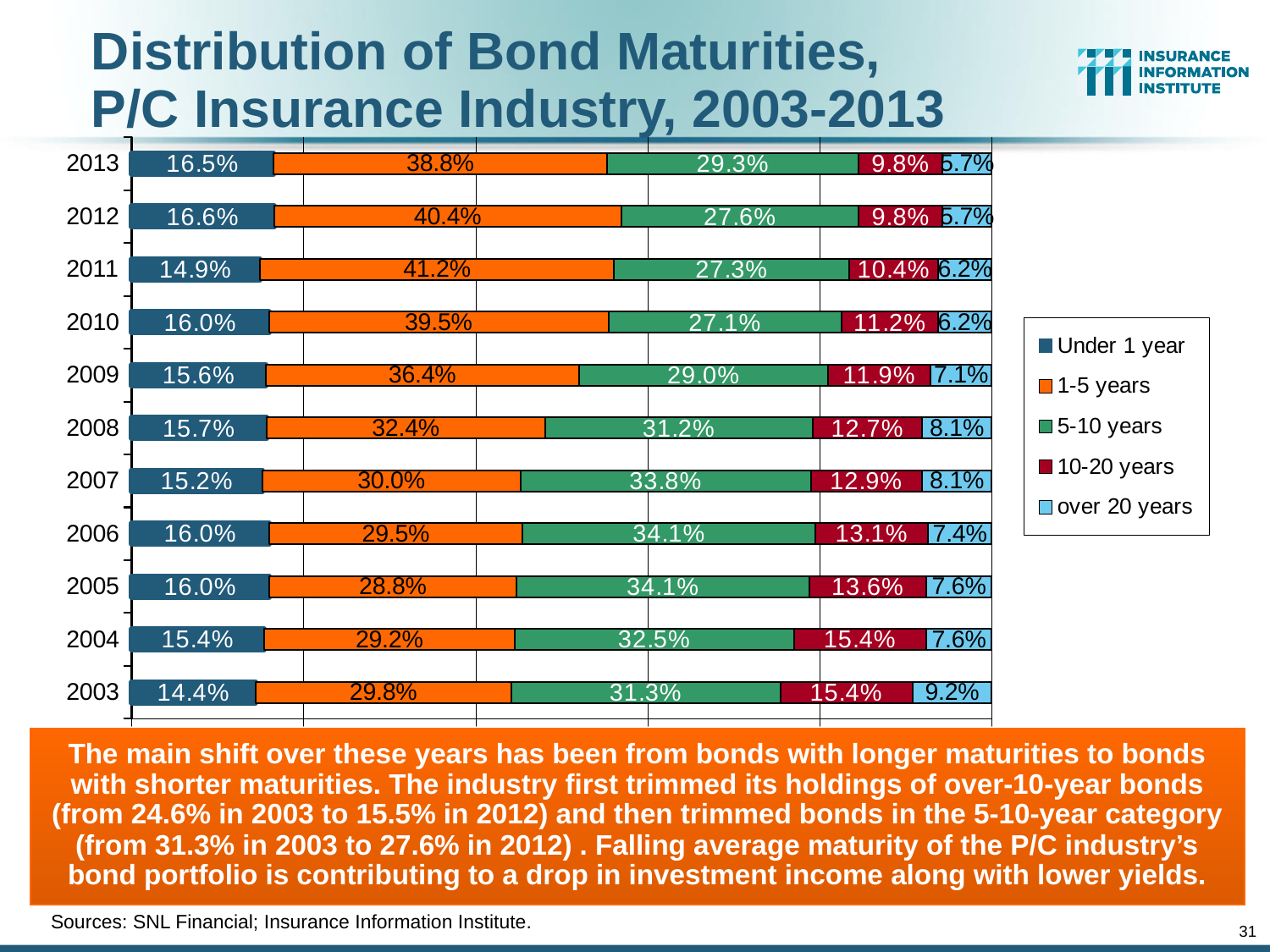
By how many percentage points did the 1-5 years share in 2013 exceed the 1-5 years share in 2003? 9.0 percentage points Which year had a larger 5-10 years share, 2006 or 2013? 2006 How many years are shown on the chart? 11 Which maturity category is listed first in the legend? Under 1 year What was the 5-10 years share in 2003? 31.3% Which year had the highest share of bonds in the 1-5 years category? 2011 Which year had the lowest share of bonds in the Under 1 year category? 2003 What was the 10-20 years share in 2004? 15.4% Did the 10-20 years share rise or fall from 2003 to 2013? Fall How many maturity categories does the legend list? 5 What share of bonds had maturities of 1-5 years in 2011? 41.2% What type of chart is shown on the slide? Stacked bar chart